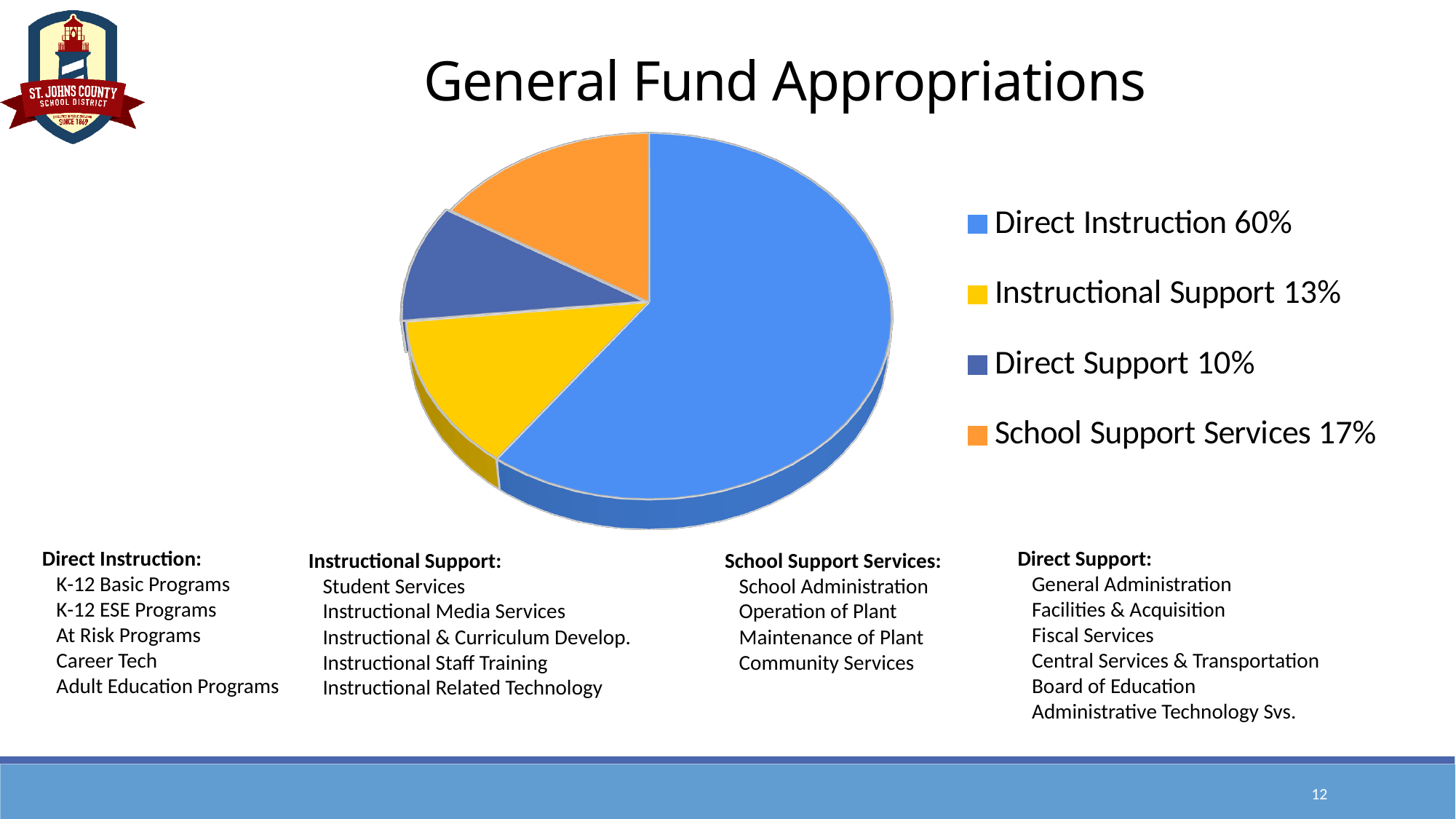
What share of General Fund Appropriations goes to Direct Support? 10% What kind of chart is shown on the slide? pie chart Which category has the smallest share of the pie? Direct Support Which category has the largest share of the pie? Direct Instruction What is the title of the chart? General Fund Appropriations What colour is the Instructional Support slice? yellow How many slices does the pie chart have? 4 Which is larger, the share for School Support Services or the share for Instructional Support? School Support Services What share of General Fund Appropriations goes to School Support Services? 17% What share of General Fund Appropriations goes to Direct Instruction? 60% What is the difference in percentage points between Direct Instruction and School Support Services? 43